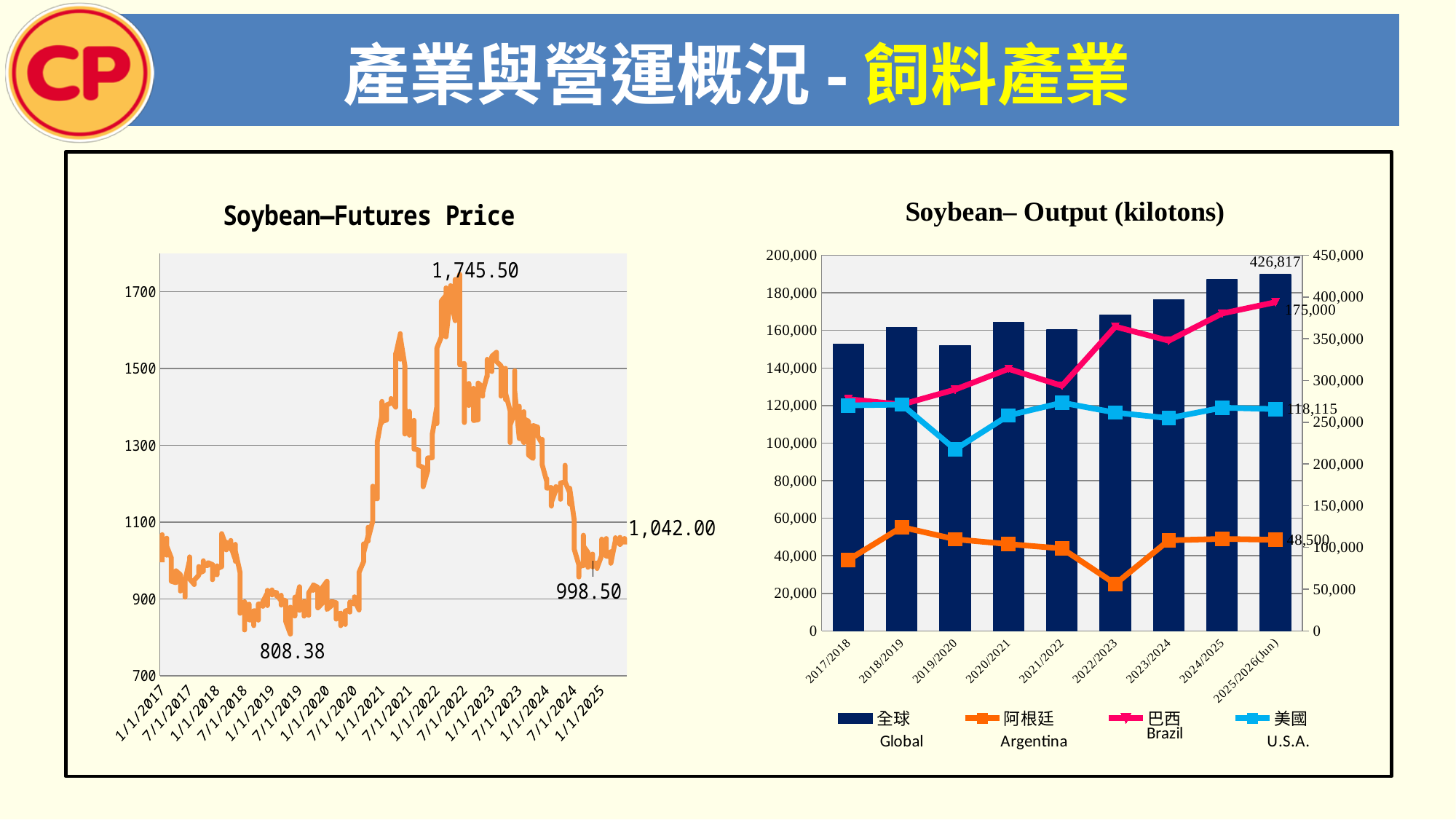
On the Soybean– Output (kilotons) chart, what is the labelled Argentina output for 2025/2026(Jun)? 48,500 On the Soybean–Futures Price chart, what is the lowest labelled price? 808.38 On the Soybean– Output (kilotons) chart, in which crop year is the Argentina output lowest? 2022/2023 On the Soybean– Output (kilotons) chart, what is the labelled Brazil output for 2025/2026(Jun)? 175,000 On the Soybean– Output (kilotons) chart, what is the labelled Global output for 2025/2026(Jun)? 426,817 How many crop-year categories are shown on the x axis of the Soybean– Output (kilotons) chart? 9 On the Soybean–Futures Price chart, what is the difference between the highest labelled price (1,745.50) and the lowest labelled price (808.38)? 937.12 How many series does the legend of the Soybean– Output (kilotons) chart list? 4 On the Soybean– Output (kilotons) chart, what is the labelled U.S.A. output for 2025/2026(Jun)? 118,115 On the Soybean–Futures Price chart, what is the highest labelled price? 1,745.50 What kind of chart is the Soybean–Futures Price chart? line chart On the Soybean–Futures Price chart, what is the most recent labelled price at the right end of the line? 1,042.00